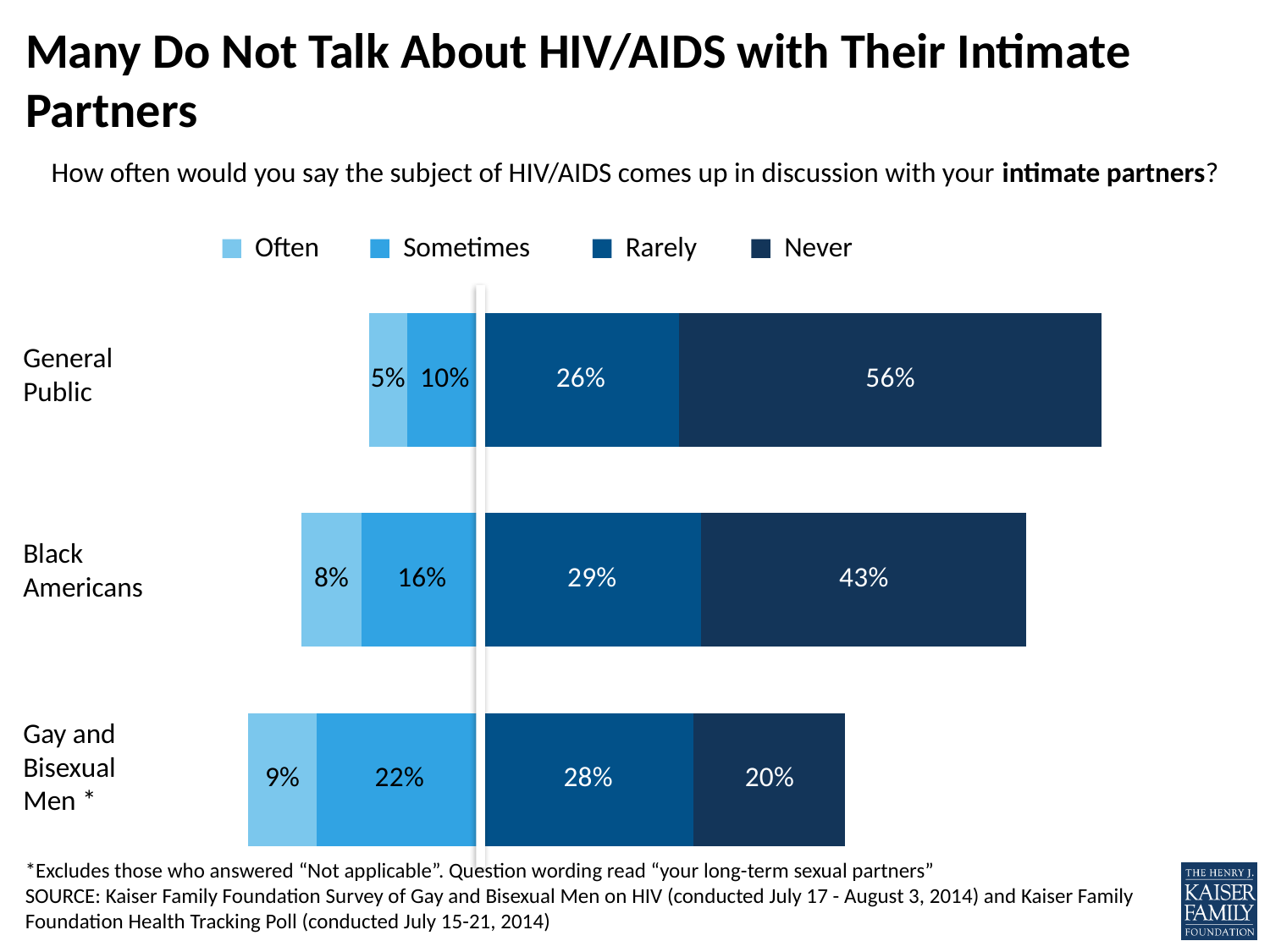
What percentage of Black Americans say the subject comes up sometimes? 16% What is the difference between the 'Never' share for the General Public and for Black Americans? 13 percentage points What percentage of the General Public say HIV/AIDS never comes up in discussion with their intimate partners? 56% Which legend entry is shown in the darkest blue? Never How many response categories does the legend list? 4 Which group has the lowest share answering 'Often'? General Public What is the combined share of Gay and Bisexual Men who say the subject comes up often or sometimes? 31% What kind of chart is shown on the slide? Stacked bar chart What percentage of Gay and Bisexual Men say the subject comes up often? 9% How many groups are shown in the chart? 3 Is the 'Sometimes' share larger for Gay and Bisexual Men or for Black Americans? Gay and Bisexual Men Which group has the highest share answering 'Never'? General Public